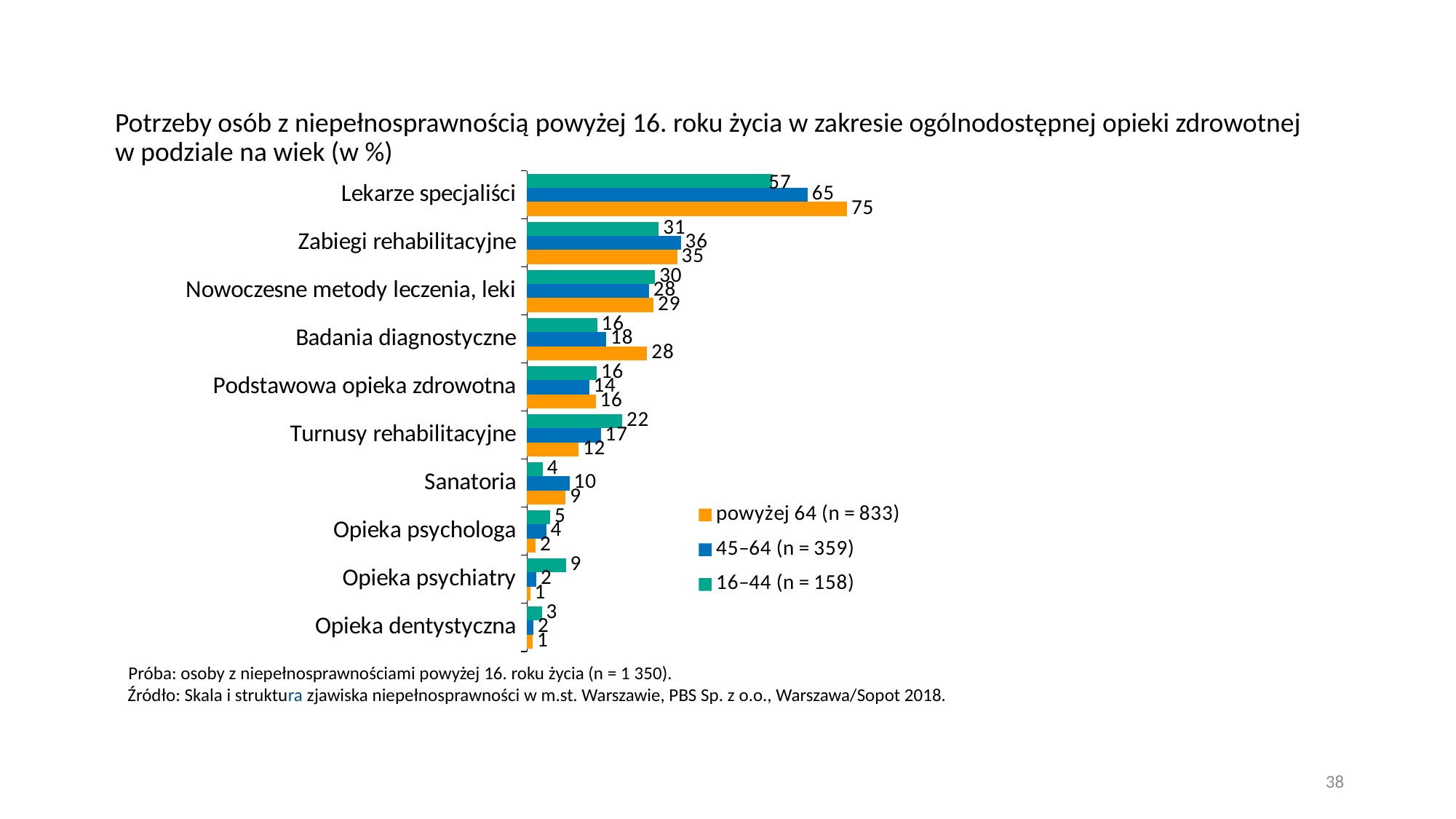
How many categories are shown on the chart? 10 How many series does the legend list? 3 What is the value for Badania diagnostyczne in the 45–64 (n = 359) series? 18 What is the value for Turnusy rehabilitacyjne in the 16–44 (n = 158) series? 22 Which category has the highest value in the 45–64 (n = 359) series? Lekarze specjaliści What is the difference between the powyżej 64 (n = 833) and 16–44 (n = 158) values for Lekarze specjaliści? 18 For Opieka psychiatry, which series has the larger value: 16–44 (n = 158) or powyżej 64 (n = 833)? 16–44 (n = 158) For Sanatoria, which series has the larger value: 45–64 (n = 359) or 16–44 (n = 158)? 45–64 (n = 359) What is the difference between the powyżej 64 (n = 833) and 45–64 (n = 359) values for Badania diagnostyczne? 10 What kind of chart is shown on the slide? Bar chart Which category has the lowest value in the 16–44 (n = 158) series? Opieka dentystyczna What is the value for Lekarze specjaliści in the powyżej 64 (n = 833) series? 75